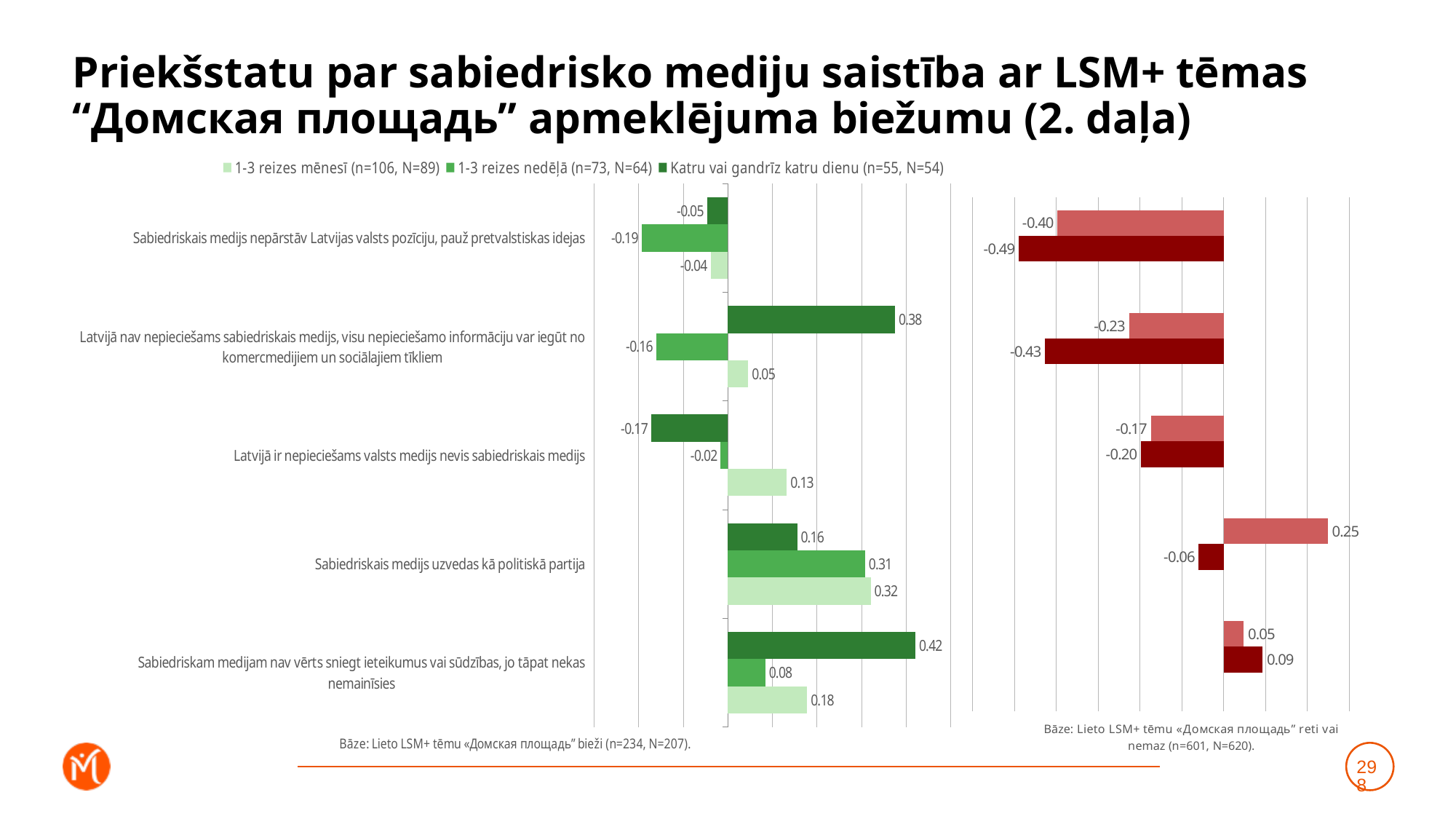
In the left chart, for 'Latvijā nav nepieciešams sabiedriskais medijs, visu nepieciešamo informāciju var iegūt no komercmedijiem un sociālajiem tīkliem', which series has the larger value: 'Katru vai gandrīz katru dienu' or '1-3 reizes mēnesī'? Katru vai gandrīz katru dienu What kind of chart is the left chart? Bar chart In the left chart, for 'Sabiedriskais medijs uzvedas kā politiskā partija', what is the difference between the '1-3 reizes mēnesī' value and the 'Katru vai gandrīz katru dienu' value? 0.16 In the left chart, which category has the lowest value for '1-3 reizes nedēļā'? Sabiedriskais medijs nepārstāv Latvijas valsts pozīciju, pauž pretvalstiskas idejas In the left chart, which category has the highest value for 'Katru vai gandrīz katru dienu'? Sabiedriskam medijam nav vērts sniegt ieteikumus vai sūdzības, jo tāpat nekas nemainīsies According to the base note under the left chart, what is the n value for the group 'Lieto LSM+ tēmu «Домская площадь» bieži'? 234 In the right chart, what is the lowest value shown? -0.49 In the left chart, what is the value for '1-3 reizes mēnesī' for the category 'Latvijā ir nepieciešams valsts medijs nevis sabiedriskais medijs'? 0.13 How many categories are shown in the left chart? 5 How many series does the legend of the left chart list? 3 In the left chart, what is the value for '1-3 reizes nedēļā' for the category 'Sabiedriskais medijs uzvedas kā politiskā partija'? 0.31 In the left chart, what is the value for 'Katru vai gandrīz katru dienu' for the category 'Sabiedriskam medijam nav vērts sniegt ieteikumus vai sūdzības, jo tāpat nekas nemainīsies'? 0.42